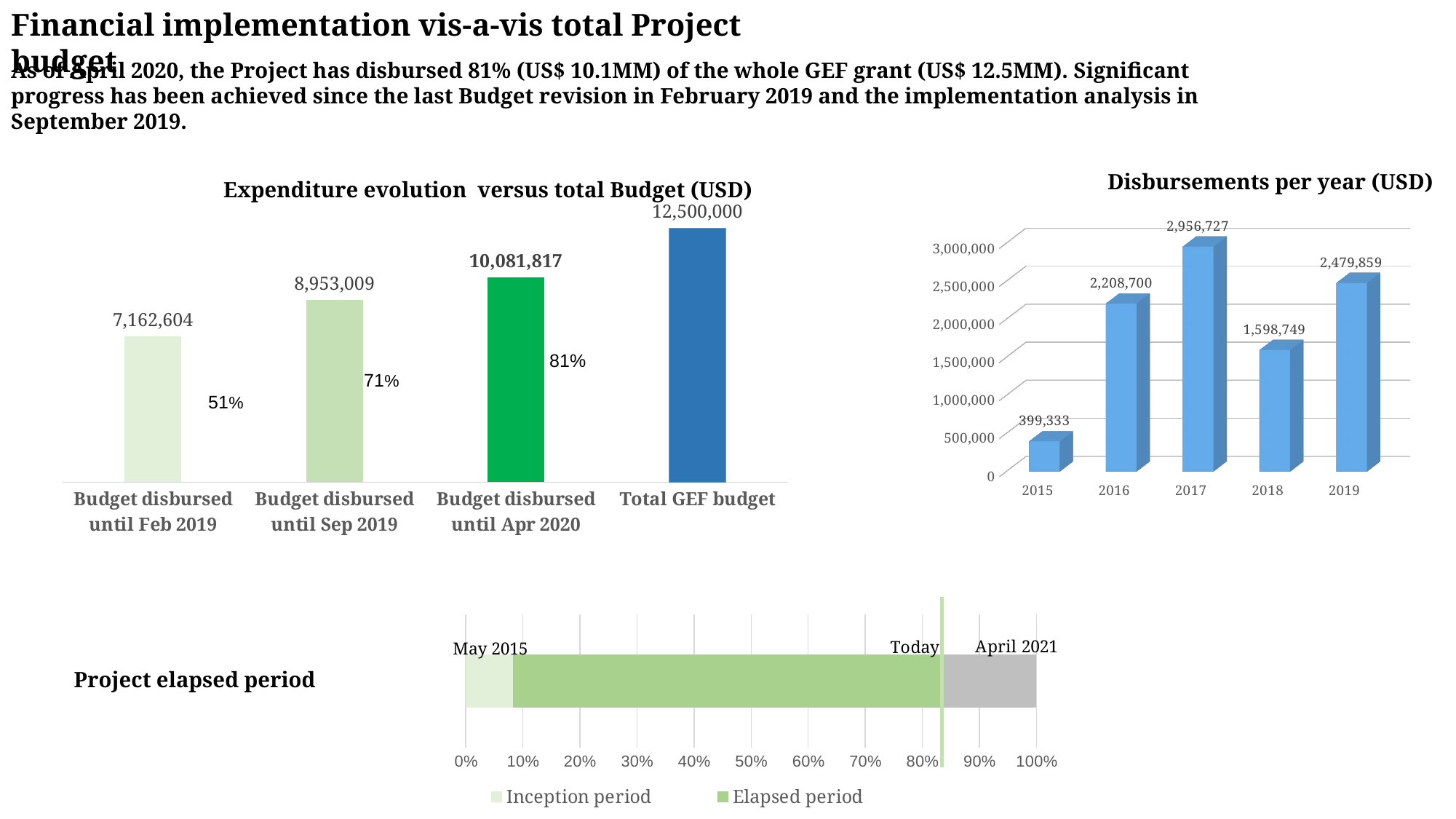
In the 'Project elapsed period' chart, how many series does the legend list? 2 In the 'Expenditure evolution versus total Budget (USD)' chart, what is the difference between 'Budget disbursed until Sep 2019' and 'Budget disbursed until Feb 2019'? 1,790,405 In the 'Expenditure evolution versus total Budget (USD)' chart, what percentage is shown next to 'Budget disbursed until Feb 2019'? 51% In the 'Disbursements per year (USD)' chart, what is the difference between the 2017 and 2018 values? 1,357,978 In the 'Disbursements per year (USD)' chart, what is the value for 2018? 1,598,749 In the 'Disbursements per year (USD)' chart, which is larger, the value for 2016 or the value for 2019? 2019 What kind of chart is 'Disbursements per year (USD)'? Bar chart In the 'Disbursements per year (USD)' chart, which year has the highest disbursement? 2017 In the 'Expenditure evolution versus total Budget (USD)' chart, what is the value for 'Total GEF budget'? 12,500,000 In the 'Disbursements per year (USD)' chart, which year has the lowest disbursement? 2015 In the 'Expenditure evolution versus total Budget (USD)' chart, how many bars are plotted? 4 In the 'Expenditure evolution versus total Budget (USD)' chart, what is the value for 'Budget disbursed until Apr 2020'? 10,081,817